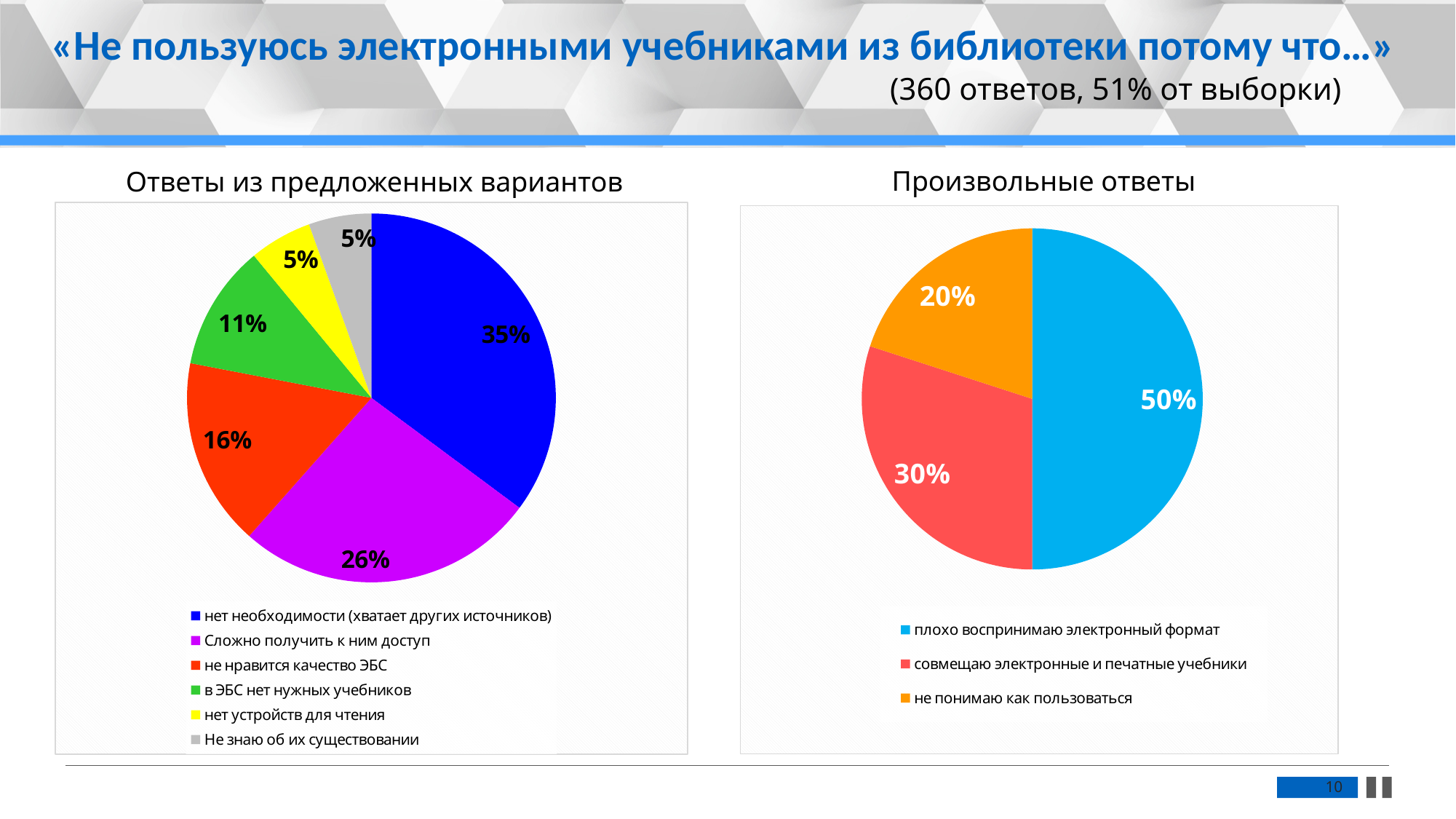
In the chart titled «Произвольные ответы», what share is labelled for «плохо воспринимаю электронный формат»? 50% In the chart titled «Произвольные ответы», which is larger: «совмещаю электронные и печатные учебники» or «не понимаю как пользоваться»? совмещаю электронные и печатные учебники In the chart titled «Ответы из предложенных вариантов», what share is labelled for «Сложно получить к ним доступ»? 26% In the chart titled «Произвольные ответы», which category has the smallest slice? не понимаю как пользоваться In the chart titled «Ответы из предложенных вариантов», what share is labelled for «не нравится качество ЭБС»? 16% In the chart titled «Ответы из предложенных вариантов», what is the difference in percentage points between «Сложно получить к ним доступ» and «в ЭБС нет нужных учебников»? 15 In the chart titled «Ответы из предложенных вариантов», what share is labelled for «нет необходимости (хватает других источников)»? 35% In the chart titled «Произвольные ответы», what share is labelled for «не понимаю как пользоваться»? 20% What type of chart is used for «Произвольные ответы»? pie chart In the chart titled «Произвольные ответы», what colour is the slice for «совмещаю электронные и печатные учебники»? red In the chart titled «Ответы из предложенных вариантов», which category has the largest slice? нет необходимости (хватает других источников) In the chart titled «Ответы из предложенных вариантов», how many categories does the legend list? 6